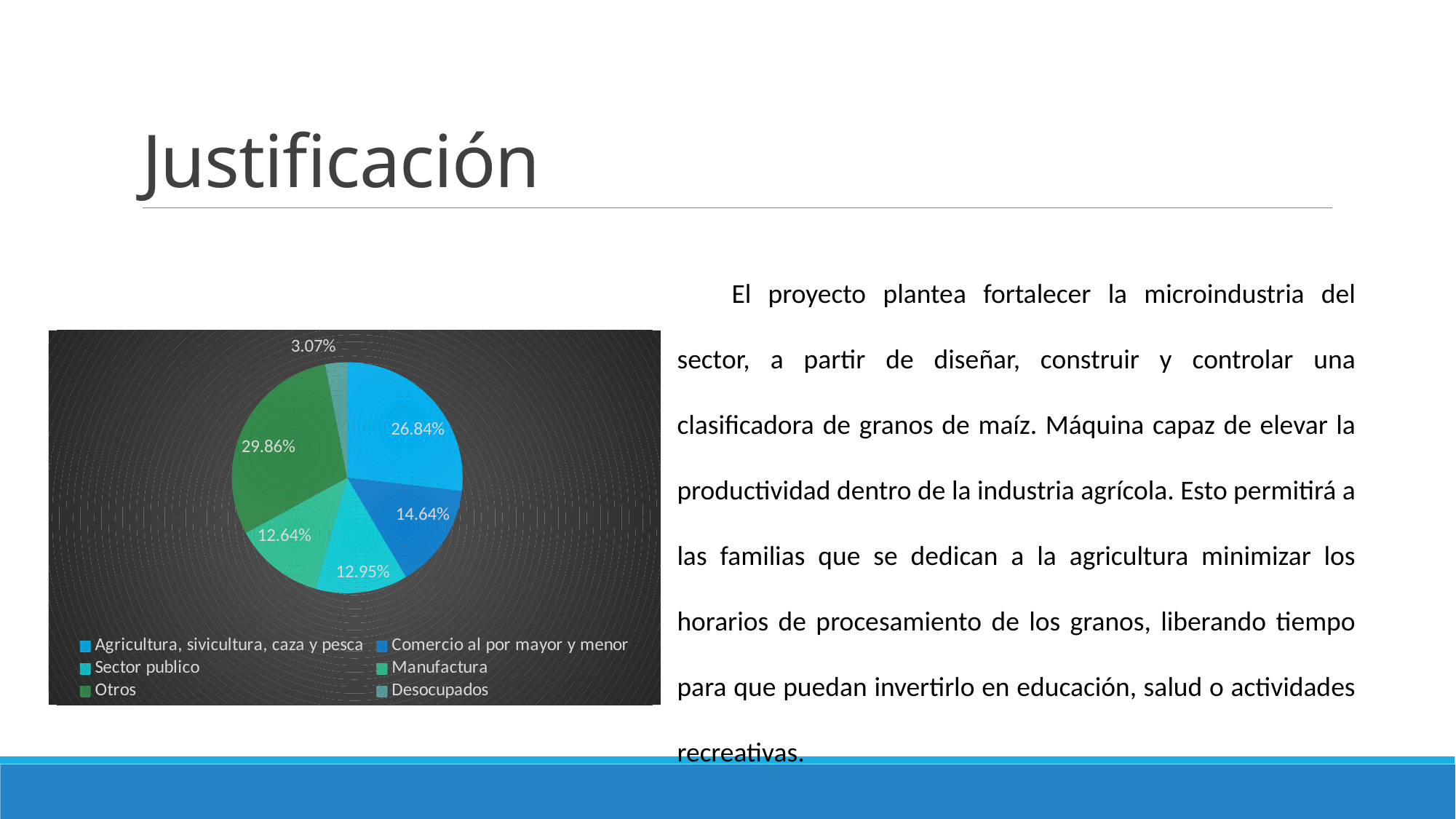
Which category has the largest share of the pie? Otros What percentage does the Otros slice represent? 29.86% What percentage does the Agricultura, sivicultura, caza y pesca slice represent? 26.84% What is the difference in percentage points between Otros and Agricultura, sivicultura, caza y pesca? 3.02 What percentage does the Desocupados slice represent? 3.07% What type of chart is shown on the slide? pie chart What percentage does the Sector publico slice represent? 12.95% Which category has the smallest share of the pie? Desocupados How many categories does the legend list? 6 What percentage does the Comercio al por mayor y menor slice represent? 14.64% Which is larger, the share for Comercio al por mayor y menor or the share for Desocupados? Comercio al por mayor y menor What percentage does the Manufactura slice represent? 12.64%